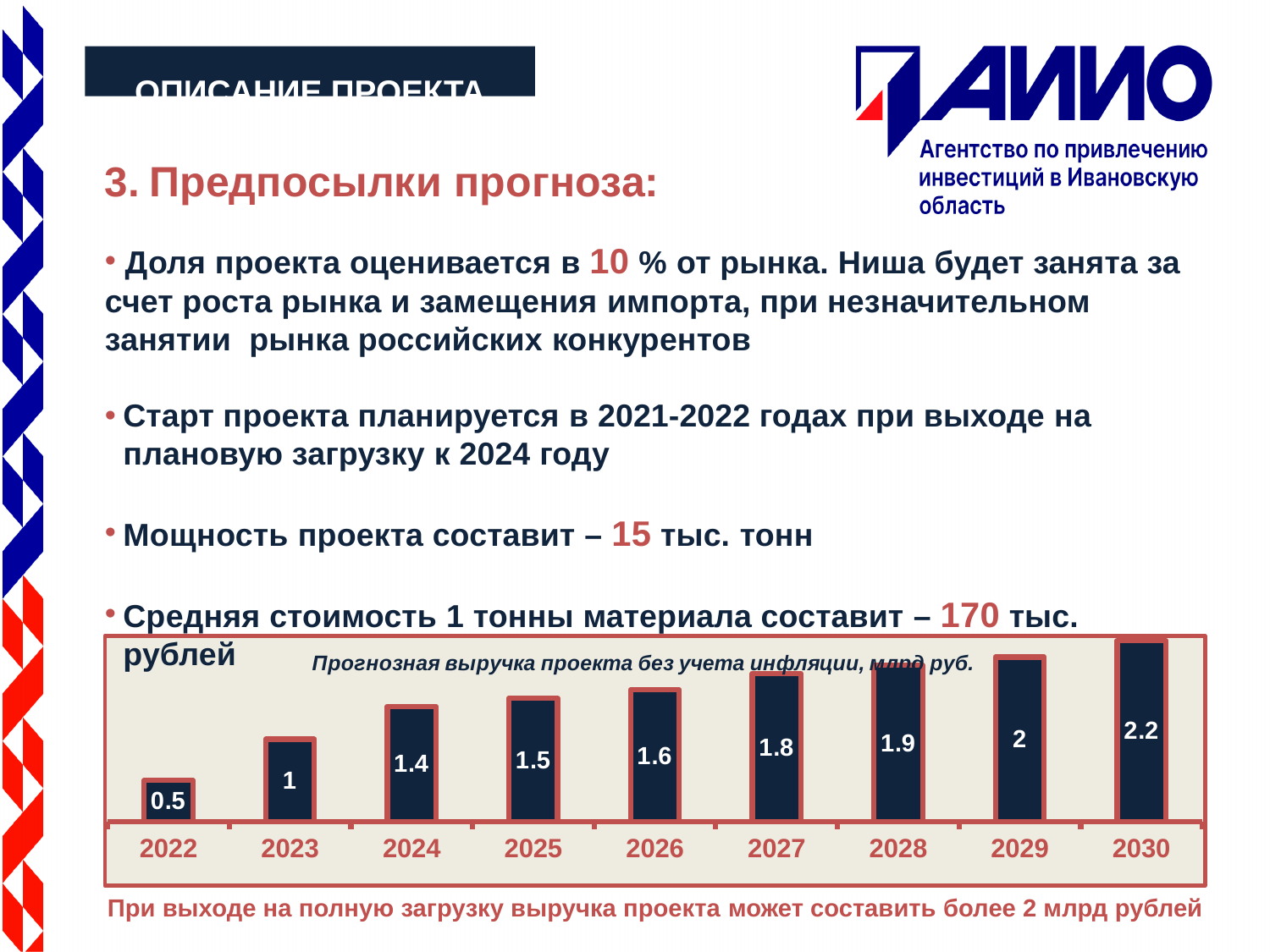
Which year has a larger forecast revenue, 2025 or 2028? 2028 What is the title of the chart? Прогнозная выручка проекта без учета инфляции, млрд руб. What is the difference between the forecast revenue for 2024 and 2023? 0.4 What is the forecast revenue for 2030? 2.2 What kind of chart is shown on the slide? Bar chart What is the forecast revenue for 2027? 1.8 What is the difference between the forecast revenue for 2030 and 2022? 1.7 Which year has the highest forecast revenue? 2030 How many years are shown on the chart? 9 Which year has the lowest forecast revenue? 2022 Do the forecast revenue values rise or fall from 2022 to 2030? Rise What is the forecast revenue for 2022? 0.5